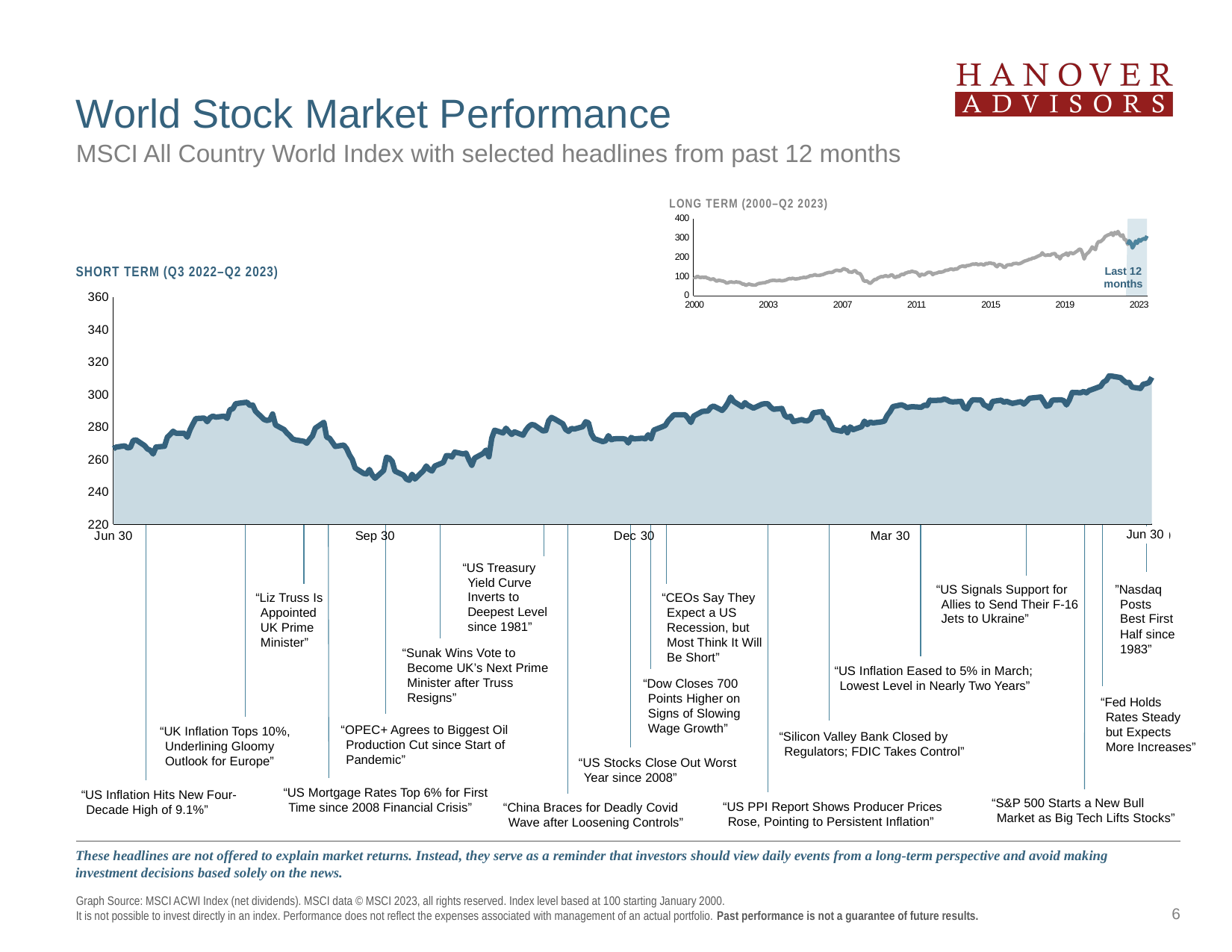
In the Short Term (Q3 2022–Q2 2023) chart, is the index value at the starting Jun 30 greater or less than 300? less What kind of chart is the Long Term (2000–Q2 2023) chart? Line chart In the Short Term (Q3 2022–Q2 2023) chart, is the index value at the final Jun 30 greater or less than 300? greater What does the shaded region at the right of the Long Term (2000–Q2 2023) chart represent, according to its label? Last 12 months In the Short Term (Q3 2022–Q2 2023) chart, is the index value at the final Jun 30 higher or lower than at the starting Jun 30? higher What kind of chart is the Short Term (Q3 2022–Q2 2023) chart? Line chart In the Long Term (2000–Q2 2023) chart, is the index value in 2000 greater or less than 200? less In the Long Term (2000–Q2 2023) chart, does the index overall rise or fall from 2000 to 2023? rise How many date labels are shown on the x axis of the Short Term (Q3 2022–Q2 2023) chart? 5 How many year labels are shown on the x axis of the Long Term (2000–Q2 2023) chart? 7